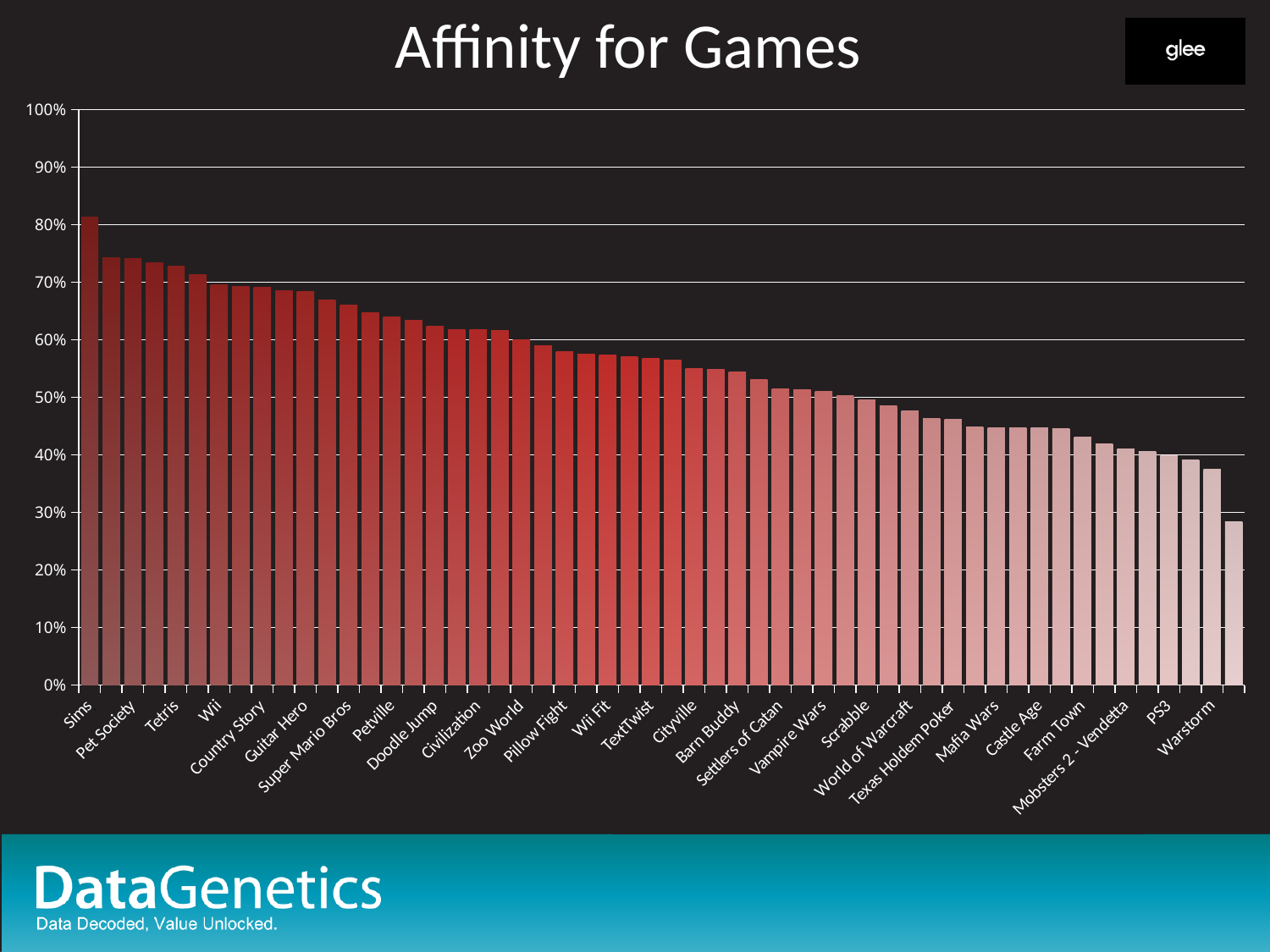
Which game has the highest affinity value in the chart? Sims Do the values rise or fall moving from left to right along the x axis? fall Is the value for Mafia Wars greater or less than 50%? less Is the value for Farm Town greater or less than 40%? greater Is the value for Tetris greater or less than 70%? greater What is the title of the chart? Affinity for Games Which has the larger value, Pet Society or Scrabble? Pet Society What kind of chart is shown on the slide? bar chart Which has the larger value, Sims or Tetris? Sims